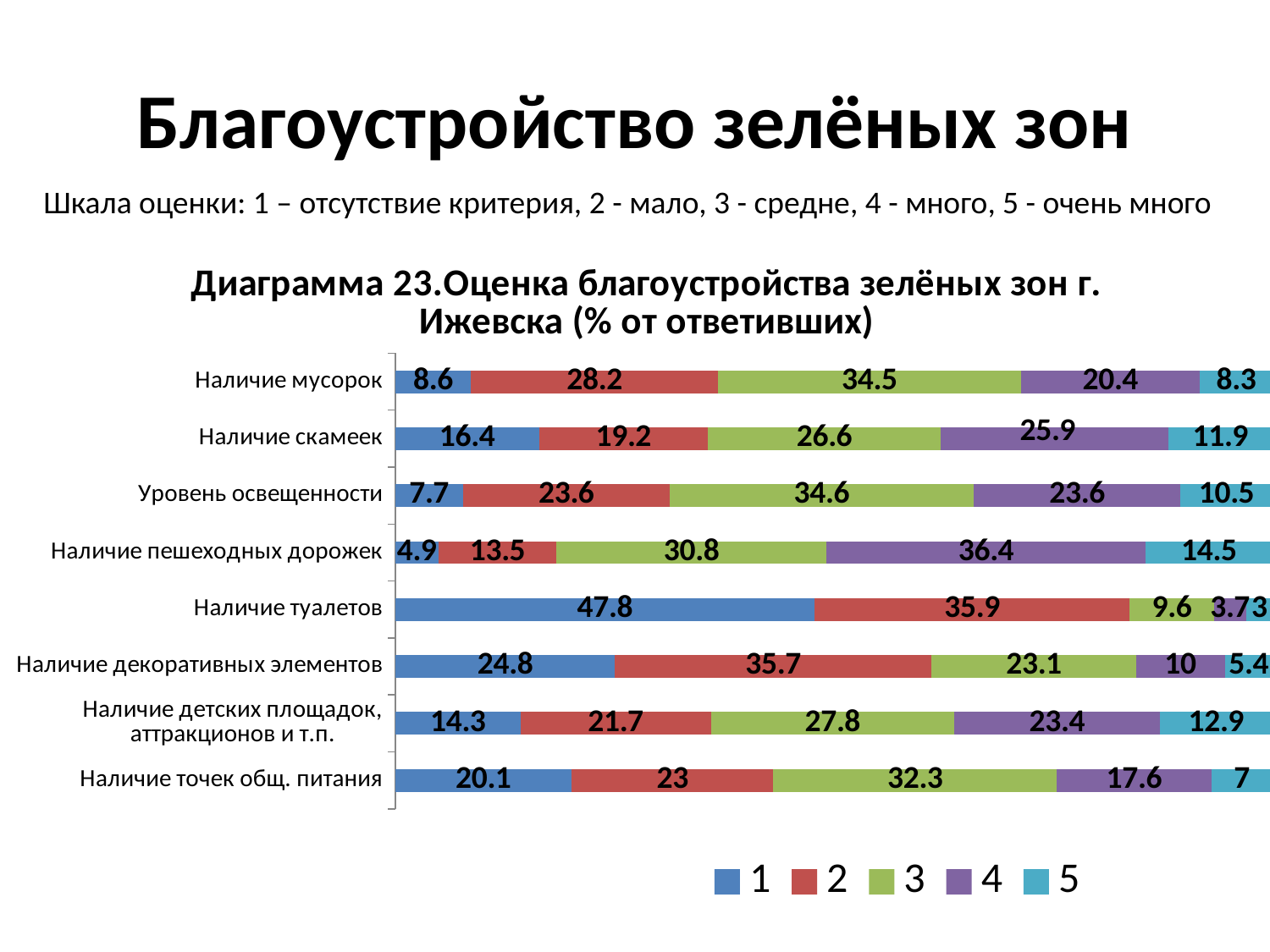
Which category has the highest value for series 1? Наличие туалетов What is the value of series 2 for "Наличие точек общ. питания"? 23 What kind of chart is shown on the slide? Stacked bar chart What is the difference between the series 3 values for "Наличие мусорок" and "Наличие скамеек"? 7.9 Which category has the lowest value for series 1? Наличие пешеходных дорожек How many series does the legend list? 5 What is the value of series 3 for "Уровень освещенности"? 34.6 What is the value of series 1 for "Наличие туалетов"? 47.8 How many categories are shown on the chart? 8 What is the value of series 5 for "Наличие детских площадок, аттракционов и т.п."? 12.9 Which category has the highest value for series 4? Наличие пешеходных дорожек Which is larger: the series 2 value for "Наличие декоративных элементов" or for "Наличие мусорок"? Наличие декоративных элементов